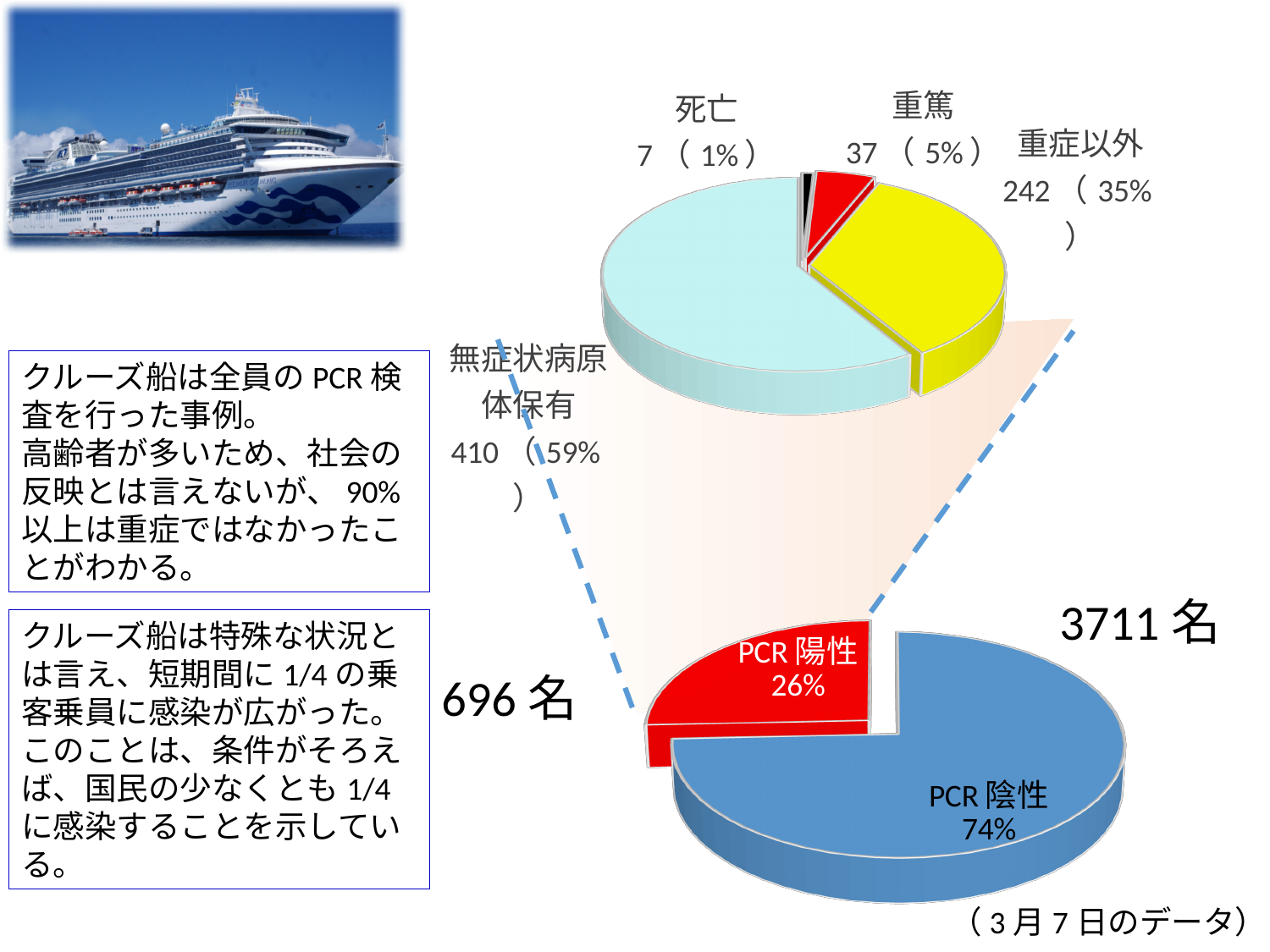
In the bottom pie chart, which slice is larger, PCR 陽性 or PCR 陰性? PCR 陰性 What kind of charts are shown on the slide? Pie charts In the top pie chart, what is the value for 無症状病原体保有? 410 (59%) In the top pie chart, how many categories are shown? 4 In the top pie chart, which category has the largest slice? 無症状病原体保有 In the top pie chart, what is the value for 重症以外? 242 (35%) In the bottom pie chart, what share is labelled PCR 陽性? 26% In the top pie chart, what is the value for 重篤? 37 (5%) In the bottom pie chart, what share is labelled PCR 陰性? 74% In the top pie chart, which category has the smallest slice? 死亡 In the top pie chart, what is the difference between the counts for 重症以外 and 重篤? 205 In the top pie chart, what is the value for 死亡? 7 (1%)